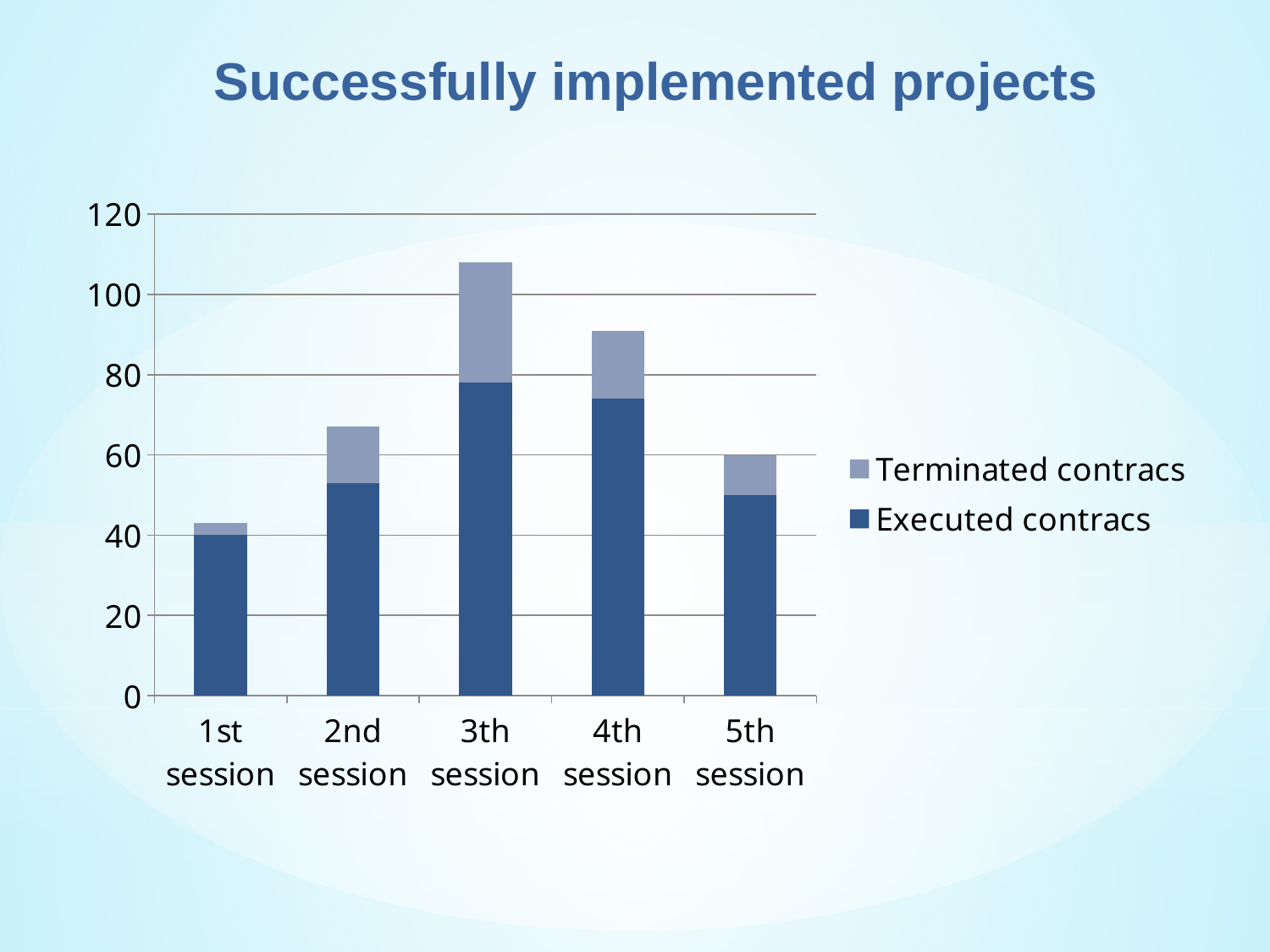
Which is larger, the total bar for the 2nd session or the total bar for the 5th session? 2nd session How many series does the legend list? 2 Is the Executed contracs value for the 2nd session greater or less than 60? less Which session has the largest Terminated contracs segment? 3th session What kind of chart is shown on the slide? stacked bar chart What is the title of the chart? Successfully implemented projects Which session has the tallest stacked bar? 3th session Which legend entry is shown in the darker blue colour? Executed contracs Is the total bar for the 3th session greater or less than 100? greater Is the Executed contracs value for the 4th session greater or less than 60? greater How many sessions are shown on the x axis? 5 Which session has the shortest stacked bar? 1st session